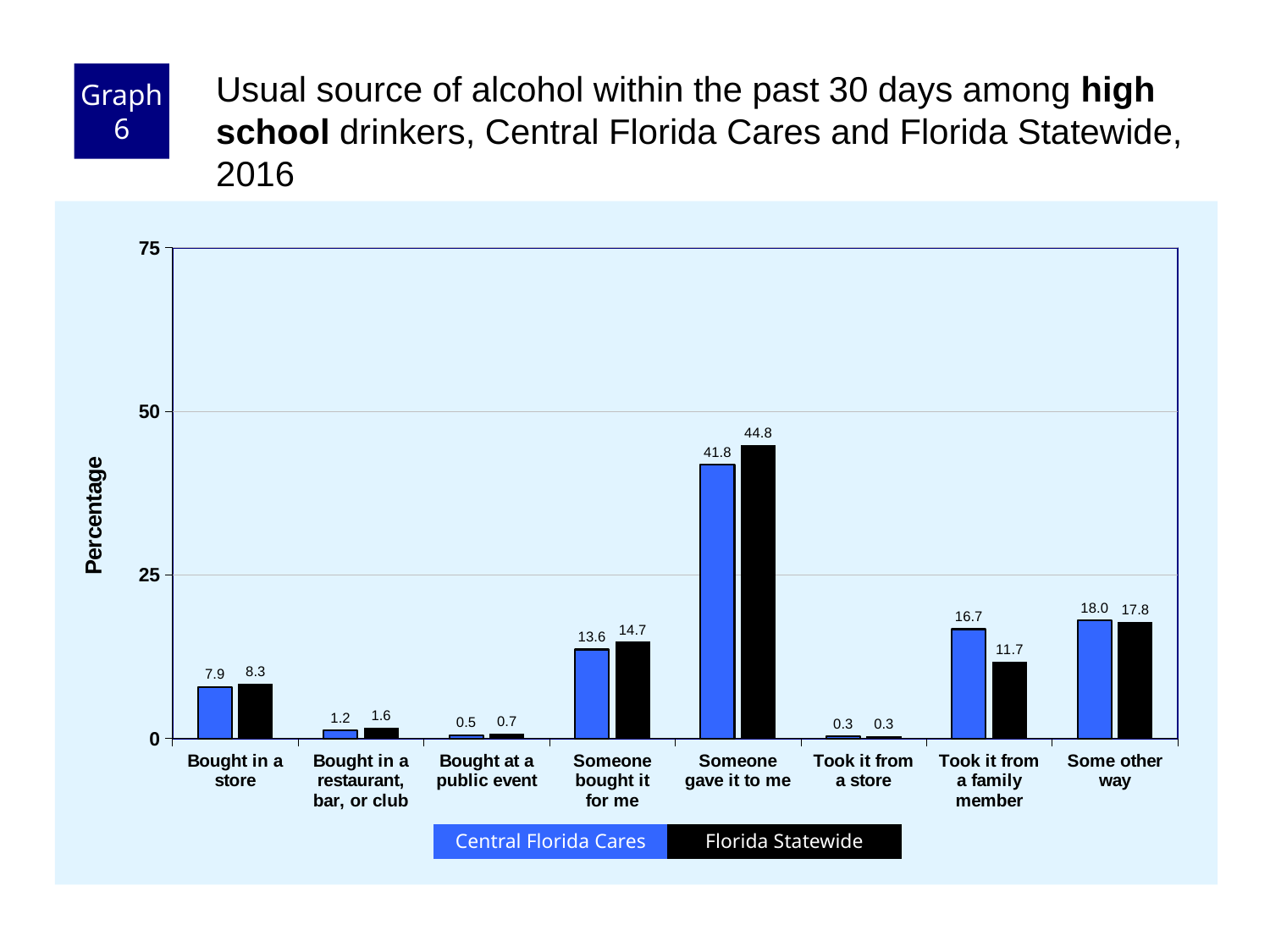
What is the difference between the Florida Statewide and Central Florida Cares values for 'Someone gave it to me'? 3.0 For 'Someone bought it for me', which series has the larger value, Central Florida Cares or Florida Statewide? Florida Statewide What kind of chart is shown on the slide? bar chart How many series does the legend list? 2 What is the Florida Statewide value for 'Took it from a family member'? 11.7 How many categories are shown on the x axis? 8 What is the difference between the Central Florida Cares and Florida Statewide values for 'Took it from a family member'? 5.0 What is the Florida Statewide value for 'Bought in a store'? 8.3 Is the Central Florida Cares value for 'Someone gave it to me' greater or less than 50? less Which category has the highest Florida Statewide value? Someone gave it to me What is the Central Florida Cares value for 'Someone gave it to me'? 41.8 Which category has the lowest Central Florida Cares value? Took it from a store